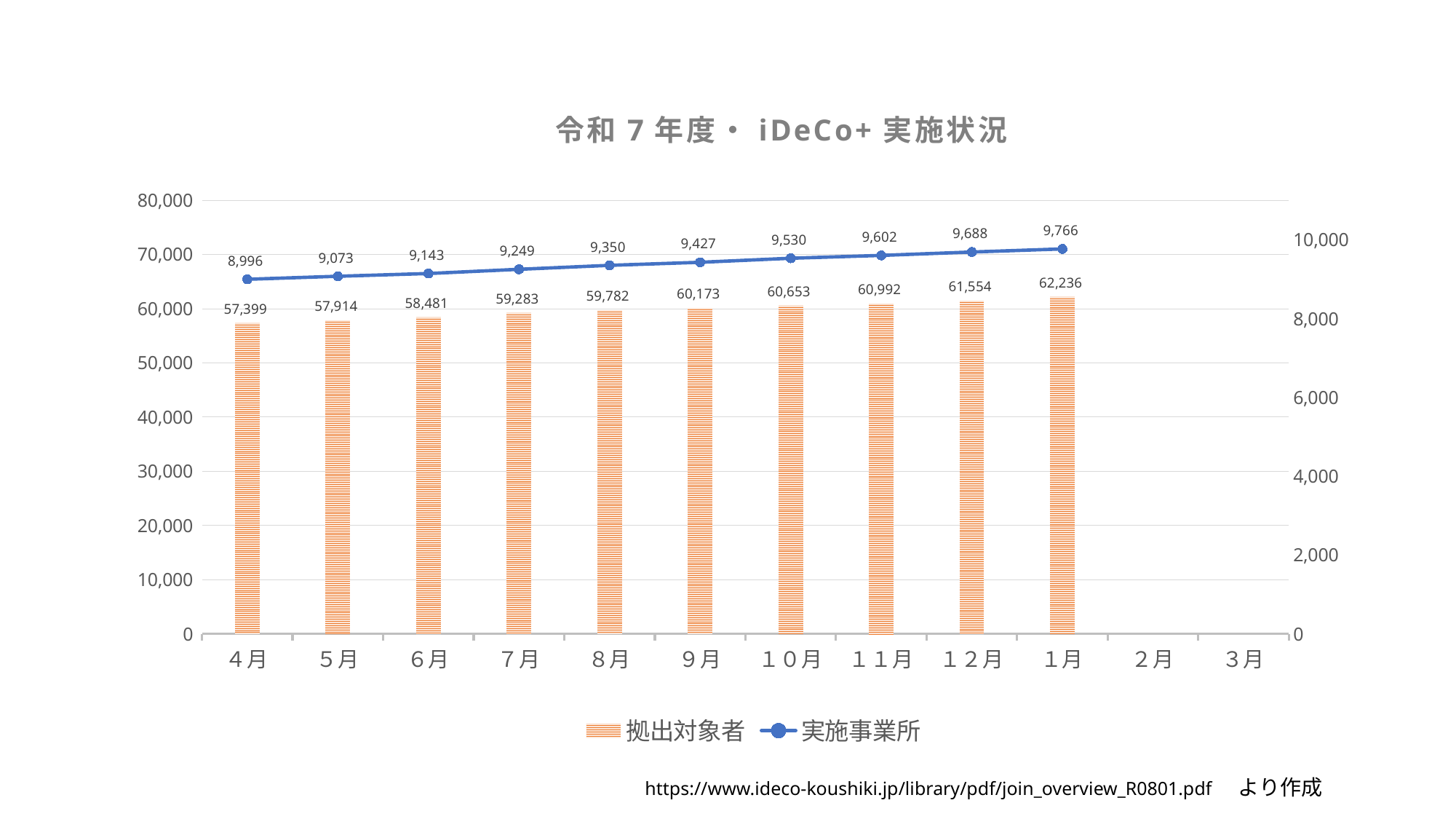
What is the value of 実施事業所 for 7月? 9,249 Which is larger, the 拠出対象者 value for 12月 or for 9月? 12月 What is the value of 拠出対象者 for 10月? 60,653 How many months have data plotted for 実施事業所? 10 How many series does the legend list? 2 In which month is 拠出対象者 highest? 1月 What is the value of 拠出対象者 for 4月? 57,399 In which month is 実施事業所 lowest? 4月 Do the 拠出対象者 values rise or fall from 4月 to 1月? rise What is the value of 実施事業所 for 1月? 9,766 What is the difference between the 拠出対象者 values for 1月 and 4月? 4,837 What is the difference between the 実施事業所 values for 1月 and 4月? 770